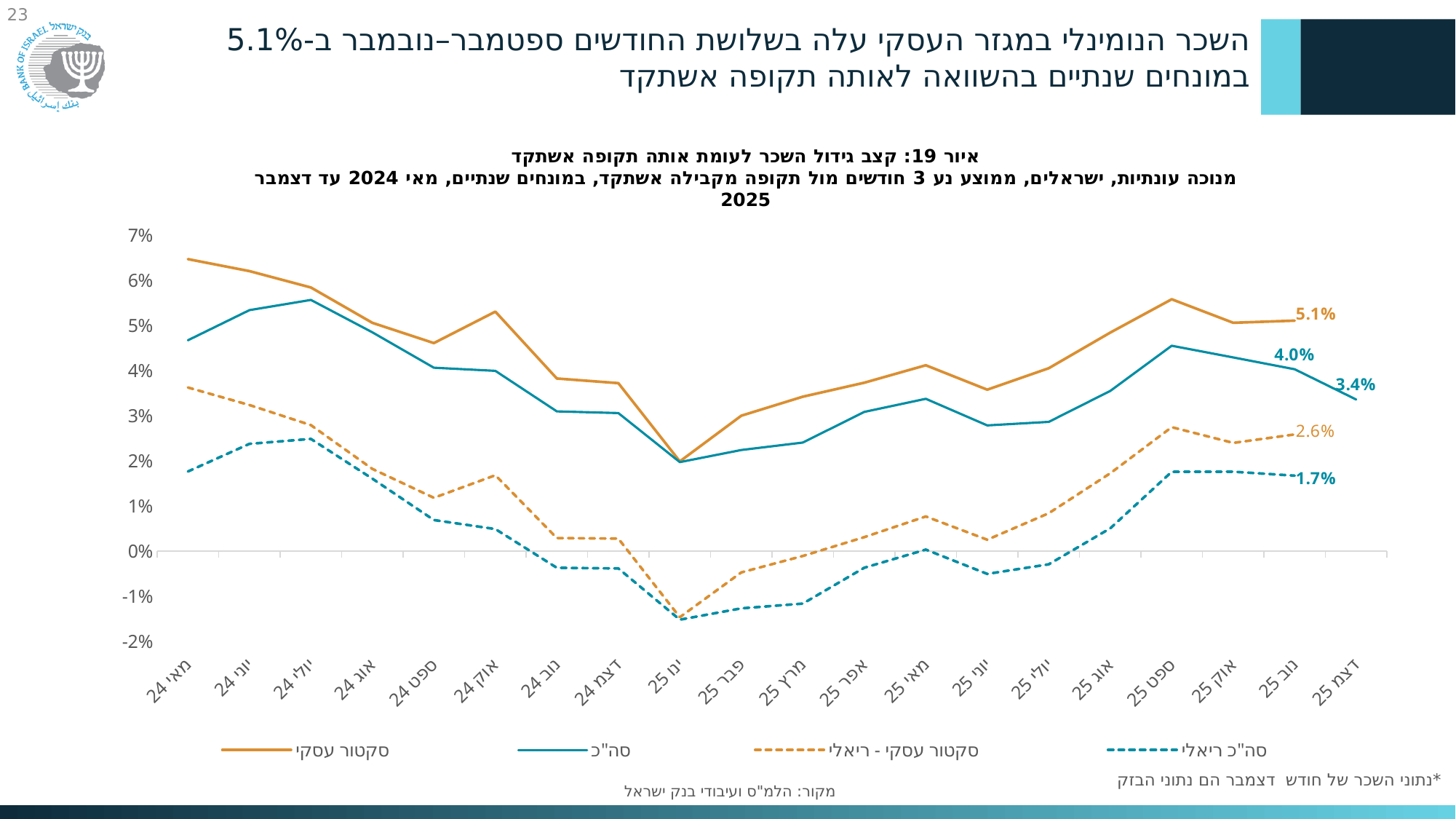
What value is labelled at the end of the סקטור עסקי - ריאלי (dashed orange) line? 2.6% Is the value of סקטור עסקי at מאי 24 greater or less than 6%? greater What value is labelled at the end of the סה"כ ריאלי (dashed teal) line? 1.7% What value is labelled at the end of the סקטור עסקי (solid orange) line? 5.1% In which month does the סקטור עסקי line reach its lowest point? ינו 25 What type of chart is shown on the slide? line chart At מאי 24, which series is higher: סקטור עסקי or סה"כ? סקטור עסקי Between ינו 25 and ספט 25, does the סקטור עסקי line rise or fall? rise What figure number is given in the chart title? איור 19 How many months are shown along the x axis? 20 Is the value of סה"כ ריאלי at ינו 25 greater or less than -1%? less How many series does the legend list? 4